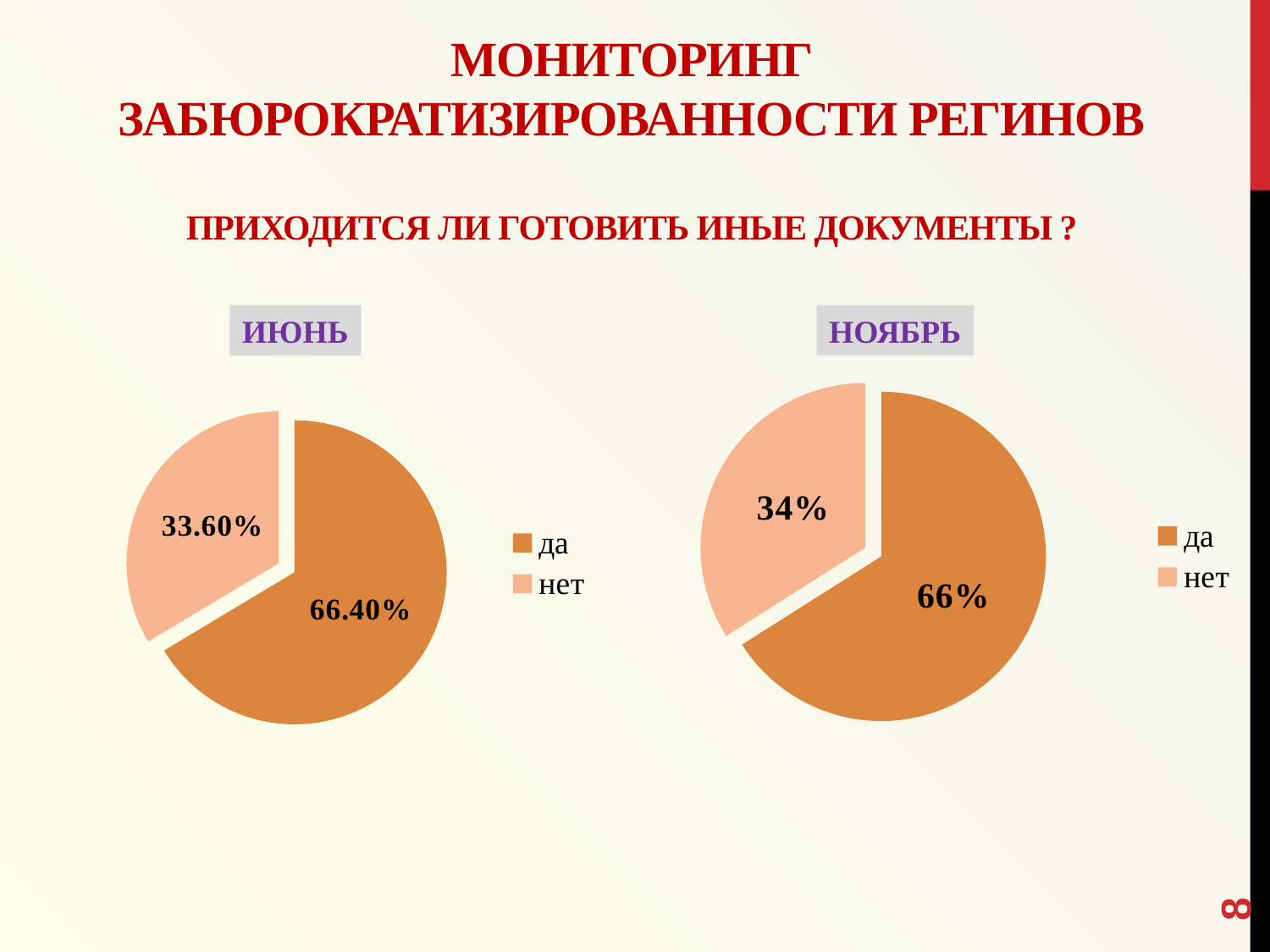
What type of chart is used for the НОЯБРЬ data? Pie chart In the ИЮНЬ pie chart, what is the difference between the да and нет values? 32.80% In the НОЯБРЬ pie chart, what is the difference between the да and нет values? 32% In the НОЯБРЬ pie chart, what is the value for да? 66% Which is larger: the нет value in the ИЮНЬ chart or the нет value in the НОЯБРЬ chart? НОЯБРЬ How many slices does the ИЮНЬ pie chart have? 2 In the ИЮНЬ pie chart, what is the value for да? 66.40% In the НОЯБРЬ pie chart, which slice is the smallest? нет In the НОЯБРЬ pie chart, what is the value for нет? 34% In the ИЮНЬ pie chart, what is the value for нет? 33.60% How many entries does the legend of the ИЮНЬ chart list? 2 In the ИЮНЬ pie chart, which slice is the largest? да